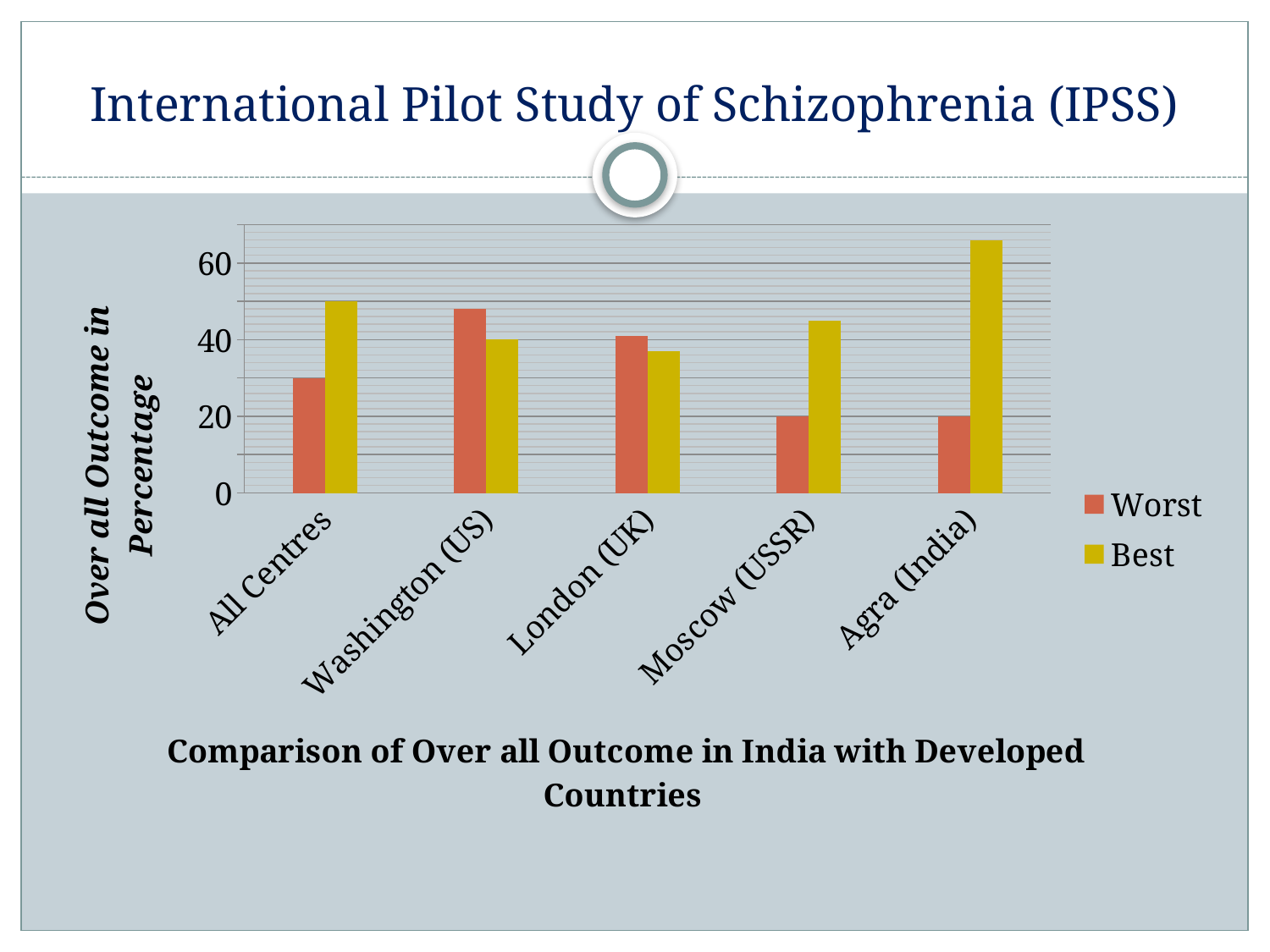
Is the Best value for Agra (India) greater or less than 60? greater Which centre has the highest Best outcome percentage? Agra (India) Is the Worst value for All Centres greater or less than 40? less How many centres are shown along the x axis? 5 Which centre has the highest Worst outcome percentage? Washington (US) What kind of chart is shown on the slide? bar chart Is the Best value for Moscow (USSR) greater or less than 40? greater What is the caption printed below the chart? Comparison of Over all Outcome in India with Developed Countries For Washington (US), which is larger, the Worst or the Best value? Worst How many series does the legend list? 2 Which centre has the lowest Best outcome percentage? London (UK) For Agra (India), which is larger, the Worst or the Best value? Best